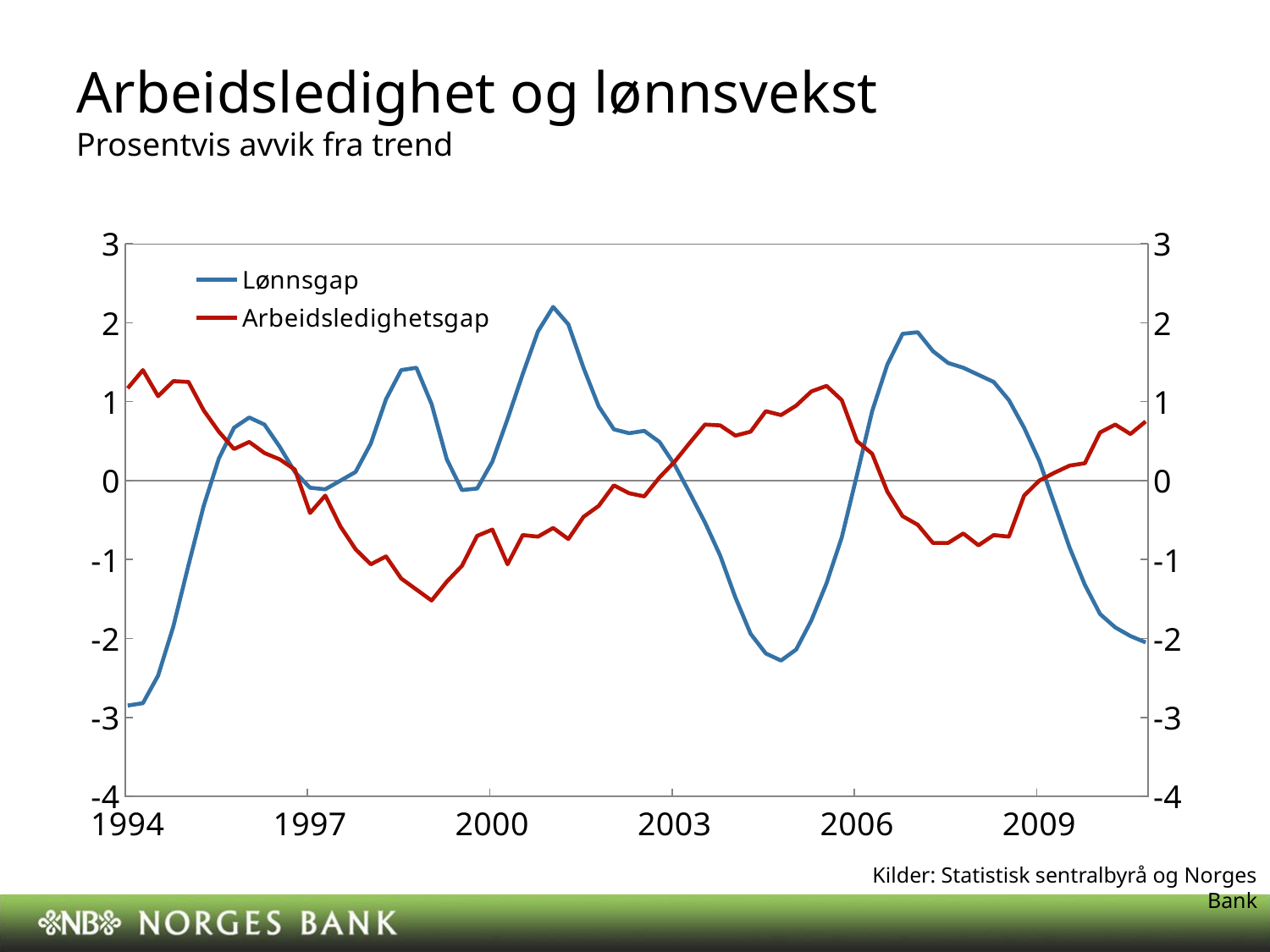
How many series does the legend list? 2 Is the value of Arbeidsledighetsgap at 1994 greater or less than 1? greater Does Lønnsgap rise or fall between 2007 and the end of the series? fall Which series is drawn in red? Arbeidsledighetsgap Is the value of Lønnsgap at 2005 greater or less than -2? less What is the title of the chart on the slide? Arbeidsledighet og lønnsvekst Is the value of Lønnsgap at 1994 greater or less than -2? less What kind of chart is shown on the slide? line chart At 1994, which series has the higher value, Lønnsgap or Arbeidsledighetsgap? Arbeidsledighetsgap Around 2001, which series has the higher value, Lønnsgap or Arbeidsledighetsgap? Lønnsgap